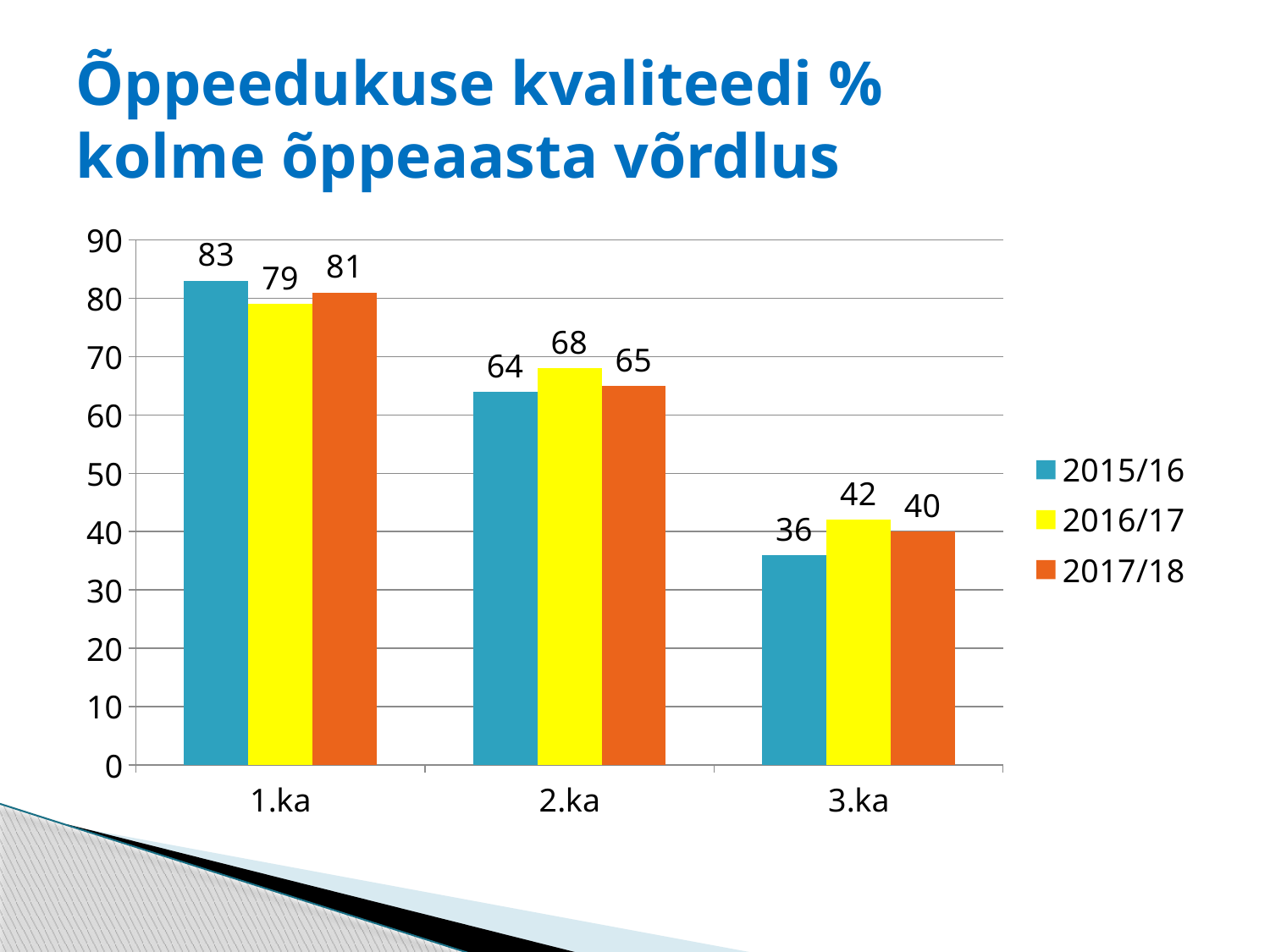
Which category has the lowest value in the 2015/16 series? 3.ka How many series does the legend list? 3 Is the value for 3.ka in the 2017/18 series greater or less than 50? less Do the values in the 2017/18 series rise or fall from 1.ka to 3.ka? fall How many categories are shown on the x axis? 3 What is the value for 1.ka in the 2015/16 series? 83 Which is larger for 2.ka: the 2015/16 value or the 2016/17 value? 2016/17 What is the value for 2.ka in the 2017/18 series? 65 What kind of chart is shown on the slide? bar chart Which category has the highest value in the 2016/17 series? 1.ka What is the difference between the 2015/16 and 2017/18 values for 3.ka? 4 What is the value for 3.ka in the 2016/17 series? 42